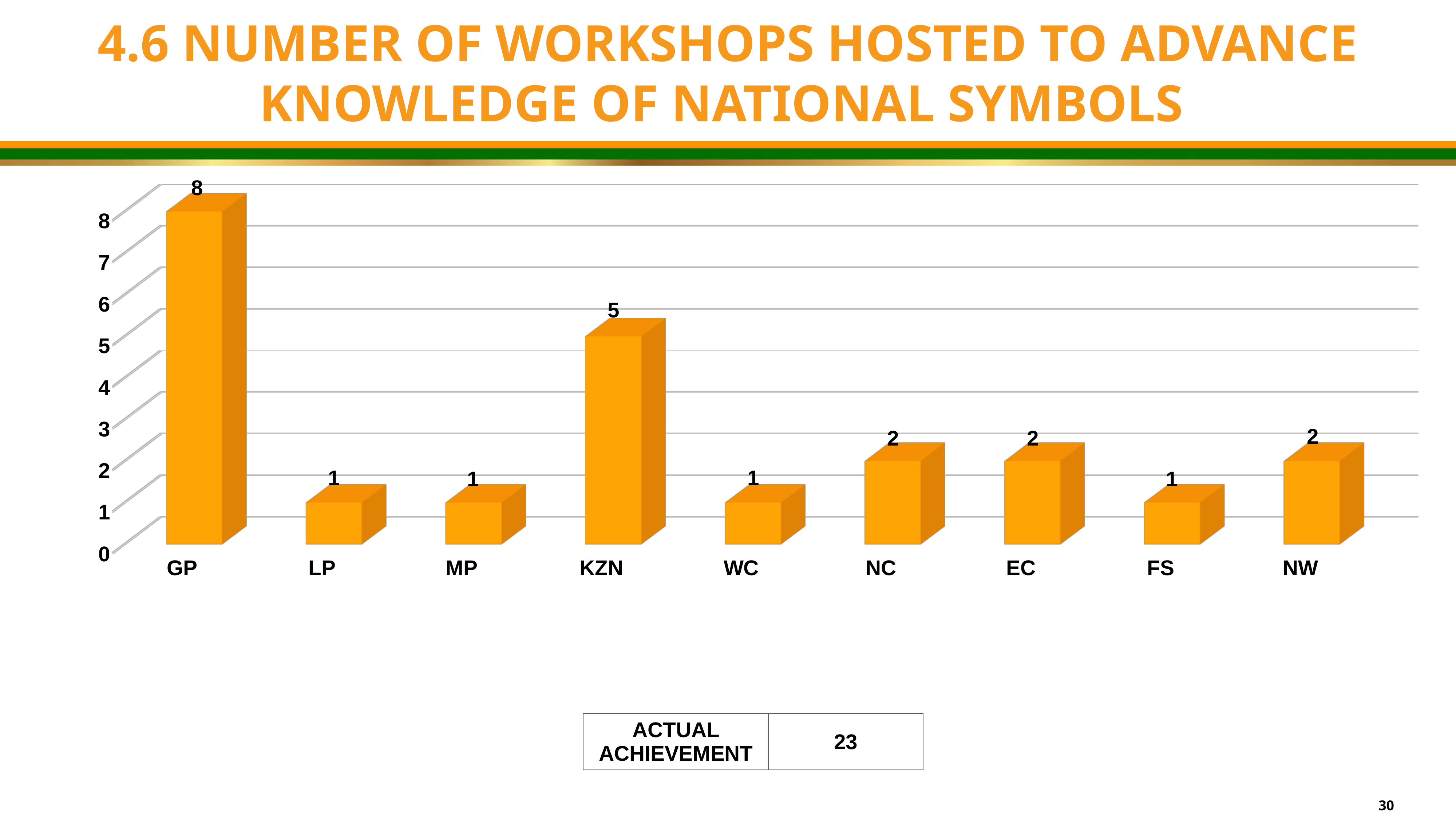
What is the number of workshops hosted for GP? 8 Which hosted more workshops, EC or MP? EC What is the number of workshops hosted for KZN? 5 What is the actual achievement figure shown in the table below the chart? 23 What is the difference between the number of workshops hosted in NW and WC? 1 What is the number of workshops hosted for FS? 1 What is the number of workshops hosted for NC? 2 How many provinces are shown on the x axis of the chart? 9 Which province hosted the highest number of workshops? GP What kind of chart is shown on the slide? bar chart What is the difference between the number of workshops hosted in GP and KZN? 3 Is the value for KZN greater or less than 4? greater